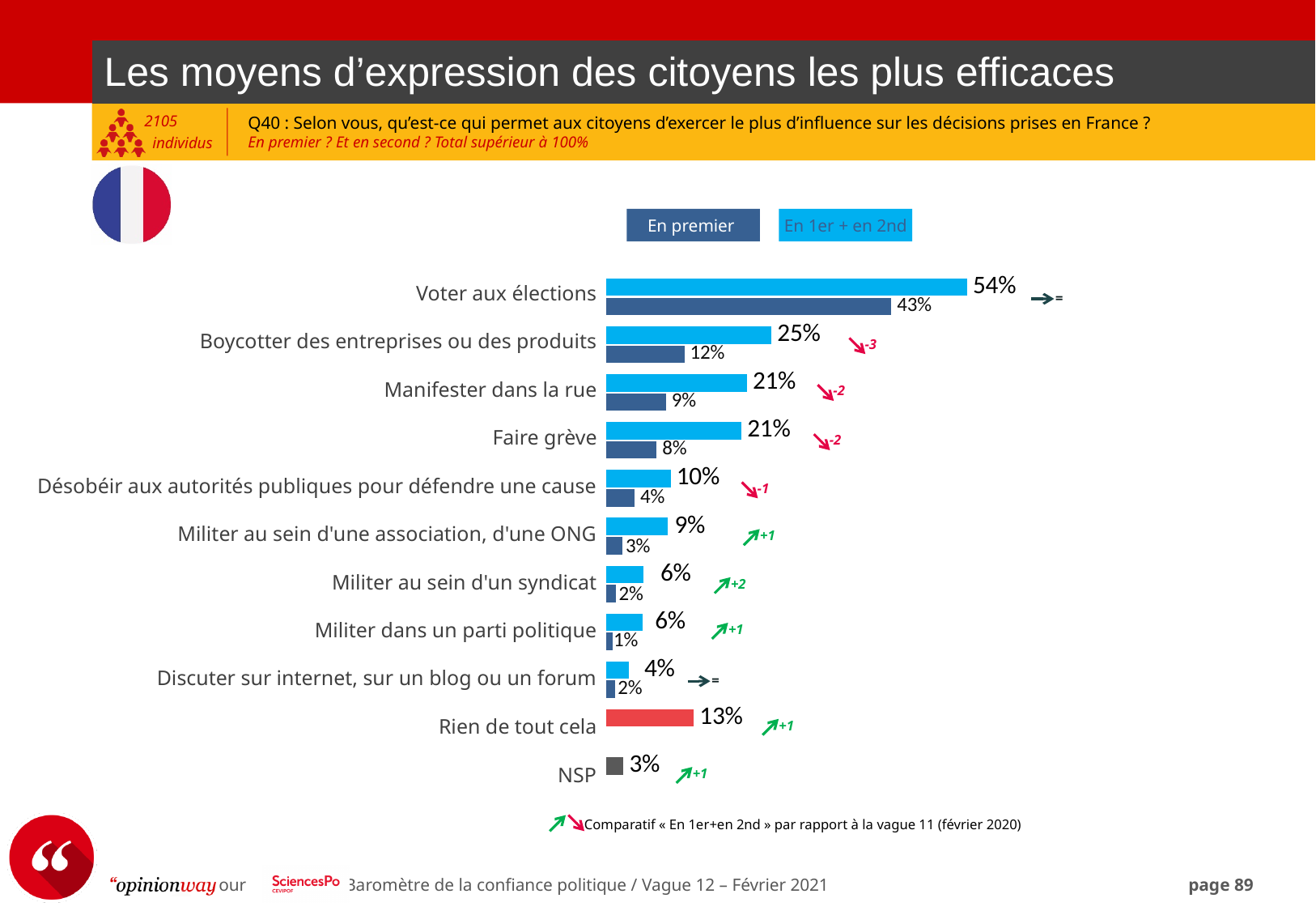
What is the 'En premier' value for 'Manifester dans la rue'? 9% Which category has the lowest 'En premier' value? Militer dans un parti politique What is the difference between the 'En 1er + en 2nd' and 'En premier' values for 'Voter aux élections'? 11% Which category has the highest 'En 1er + en 2nd' value? Voter aux élections What is the 'En premier' value for 'Boycotter des entreprises ou des produits'? 12% How many series does the legend list? 2 What is the value shown for 'Rien de tout cela'? 13% What is the value shown for 'NSP'? 3% What kind of chart is shown on the slide? Bar chart What is the difference between the 'En 1er + en 2nd' values for 'Boycotter des entreprises ou des produits' and 'Faire grève'? 4% What is the 'En 1er + en 2nd' value for 'Voter aux élections'? 54% Which is larger: the 'En 1er + en 2nd' value for 'Désobéir aux autorités publiques pour défendre une cause' or for 'Militer au sein d'une association, d'une ONG'? Désobéir aux autorités publiques pour défendre une cause